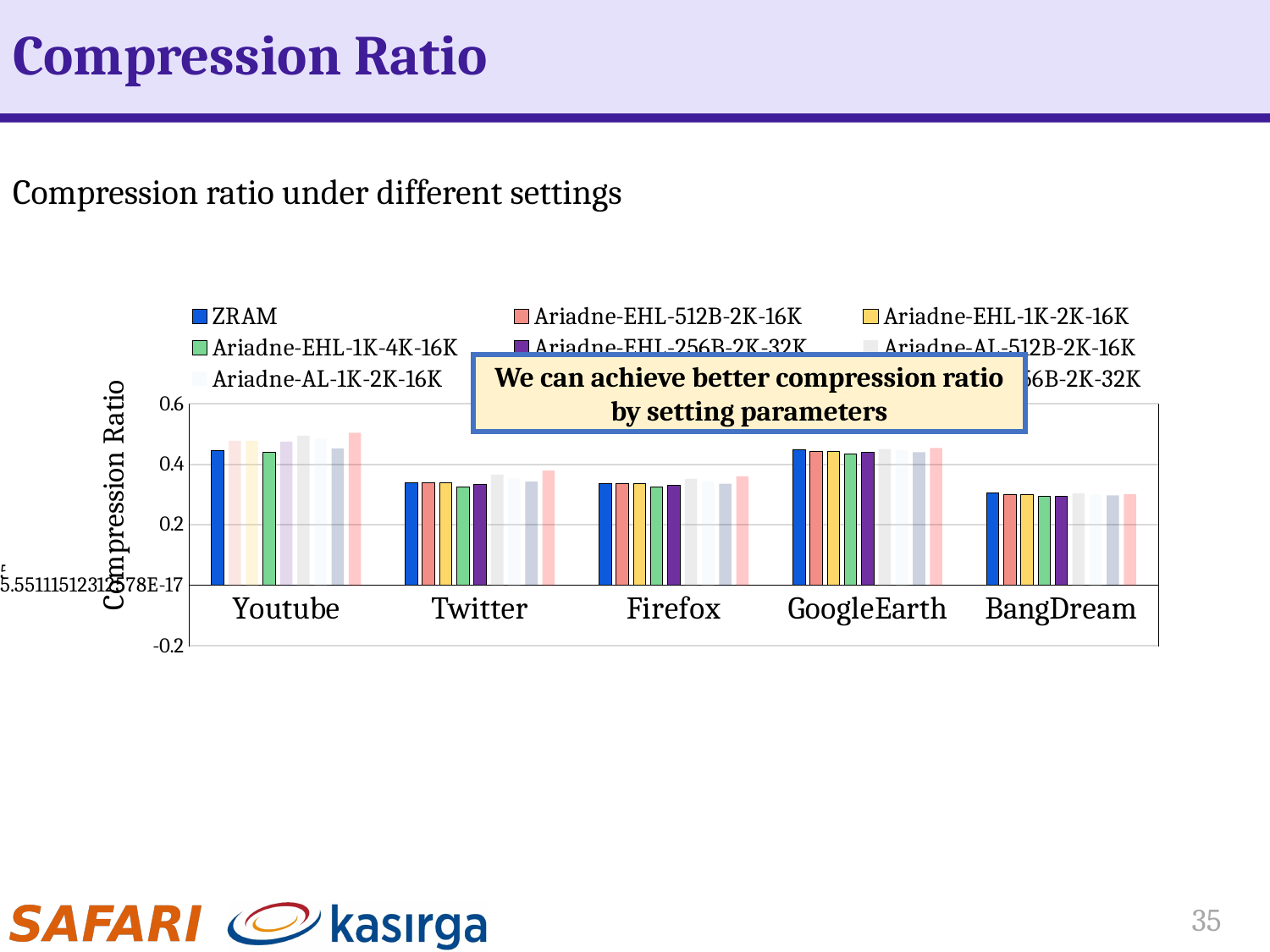
Which has the larger ZRAM compression ratio, Youtube or Twitter? Youtube Is the ZRAM value for GoogleEarth greater or less than 0.4? greater Which has the larger ZRAM compression ratio, GoogleEarth or BangDream? GoogleEarth Is the ZRAM value for Firefox greater or less than 0.4? less What kind of chart is shown on the slide? bar chart How many categories (applications) are shown on the x axis of the chart? 5 Is the ZRAM value for BangDream greater or less than 0.2? greater What is the label of the y axis of the chart? Compression Ratio Which category has the lowest ZRAM compression ratio? BangDream Which category is listed first on the x axis of the chart? Youtube